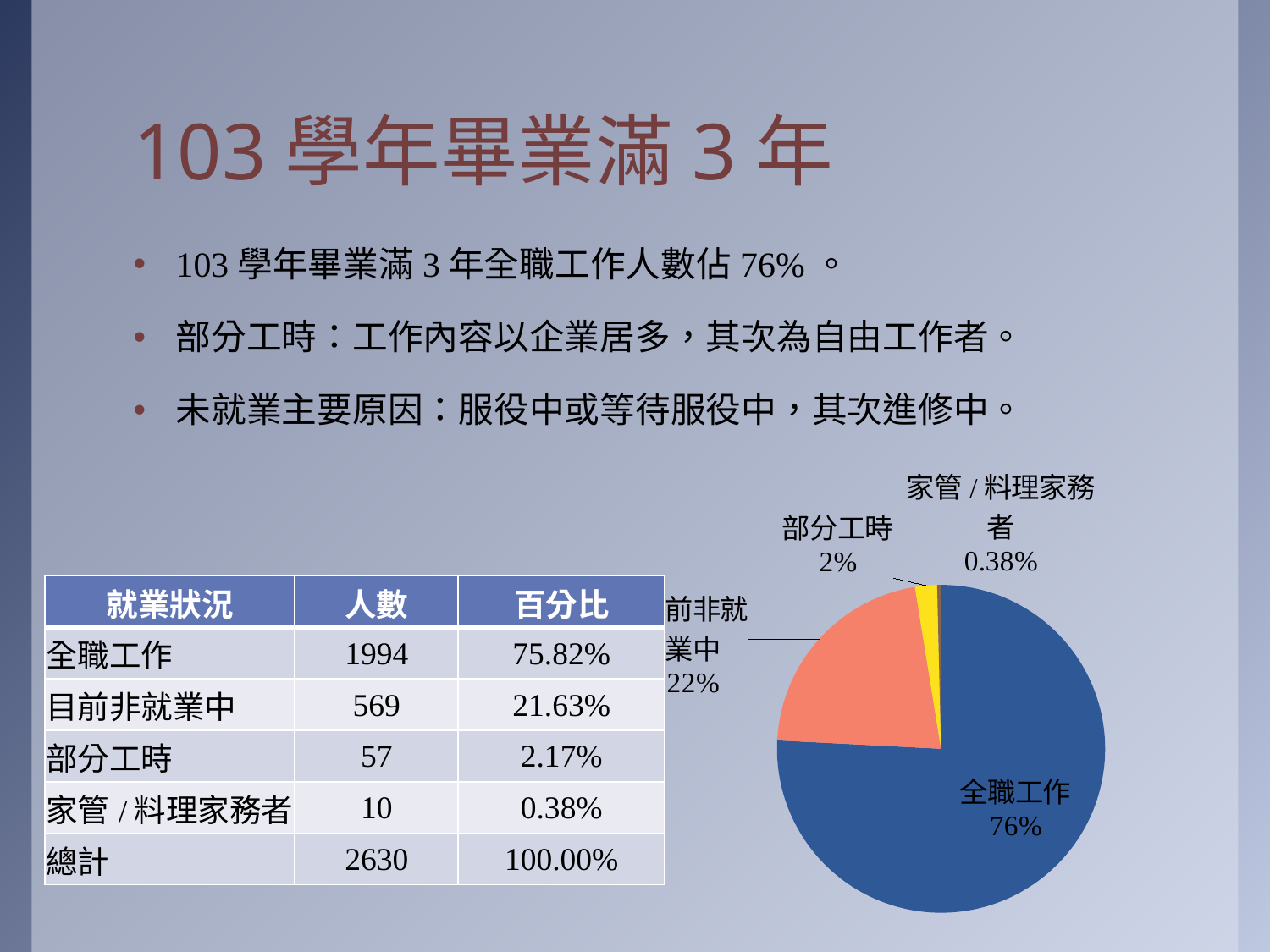
In the pie chart, what is the difference between the percentage for 全職工作 and the percentage for 目前非就業中? 54% Which category has the largest slice in the pie chart? 全職工作 In the pie chart, which is larger: the slice for 部分工時 or the slice for 目前非就業中? 目前非就業中 In the pie chart, what percentage is shown for 目前非就業中? 22% In the pie chart, what percentage is shown for 家管/料理家務者? 0.38% How many slices does the pie chart have? 4 What colour is the 全職工作 slice in the pie chart? blue Which category has the smallest slice in the pie chart? 家管/料理家務者 In the pie chart, what percentage is shown for 全職工作? 76% What kind of chart is shown on the slide? pie chart What colour is the 部分工時 slice in the pie chart? yellow In the pie chart, what percentage is shown for 部分工時? 2%